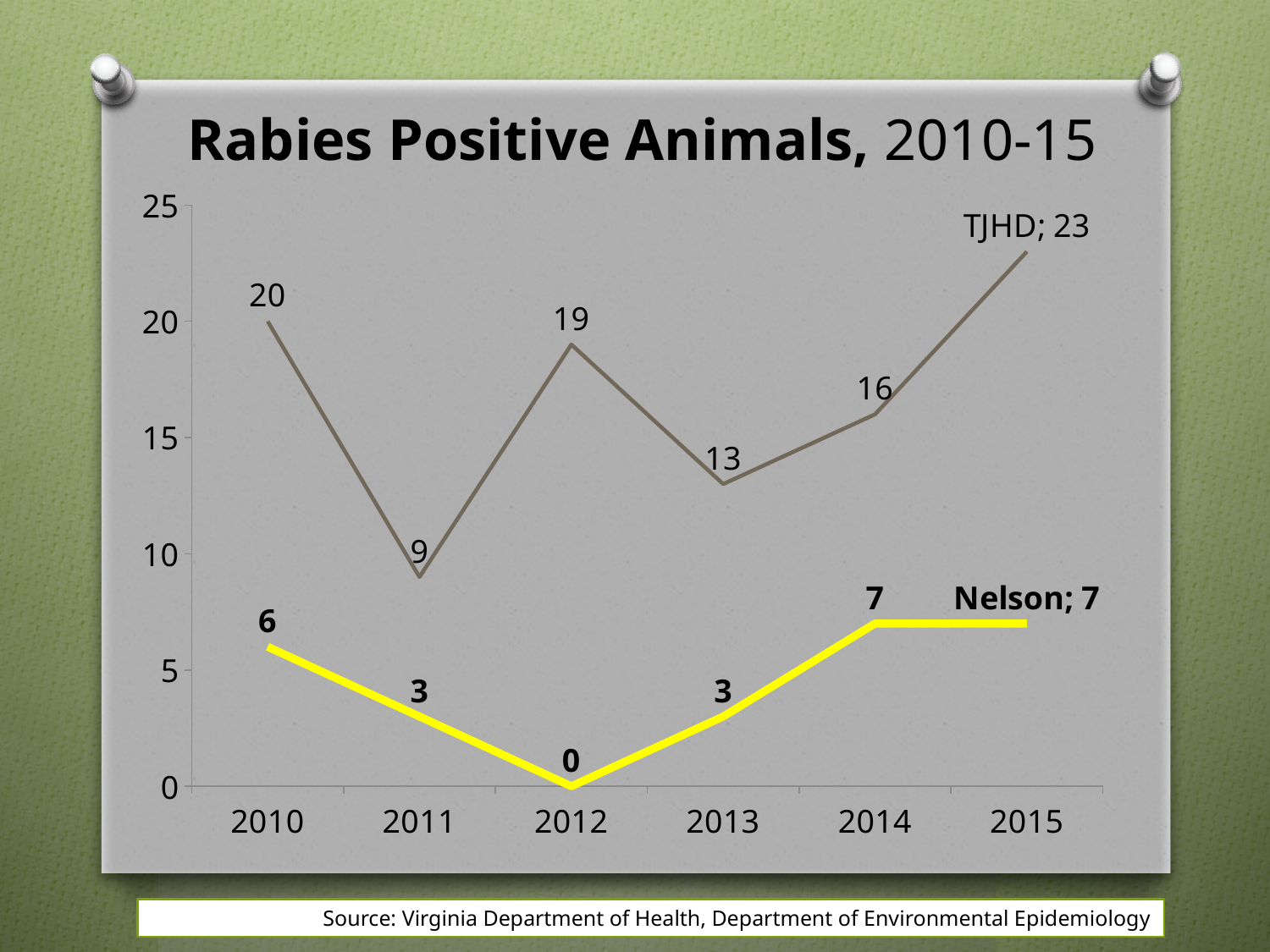
What kind of chart is shown on the slide? Line chart Did the Nelson value rise or fall from 2012 to 2014? Rise Which year had a higher TJHD value, 2011 or 2013? 2013 What is the title of the chart? Rabies Positive Animals, 2010-15 Which series is drawn in yellow? Nelson What was the TJHD value in 2012? 19 How many years are shown on the x axis? 6 How many series are plotted on the chart? 2 What is the difference between the TJHD and Nelson values in 2010? 14 In which year was the Nelson value lowest? 2012 In which year was the TJHD value highest? 2015 What was the Nelson value in 2014? 7